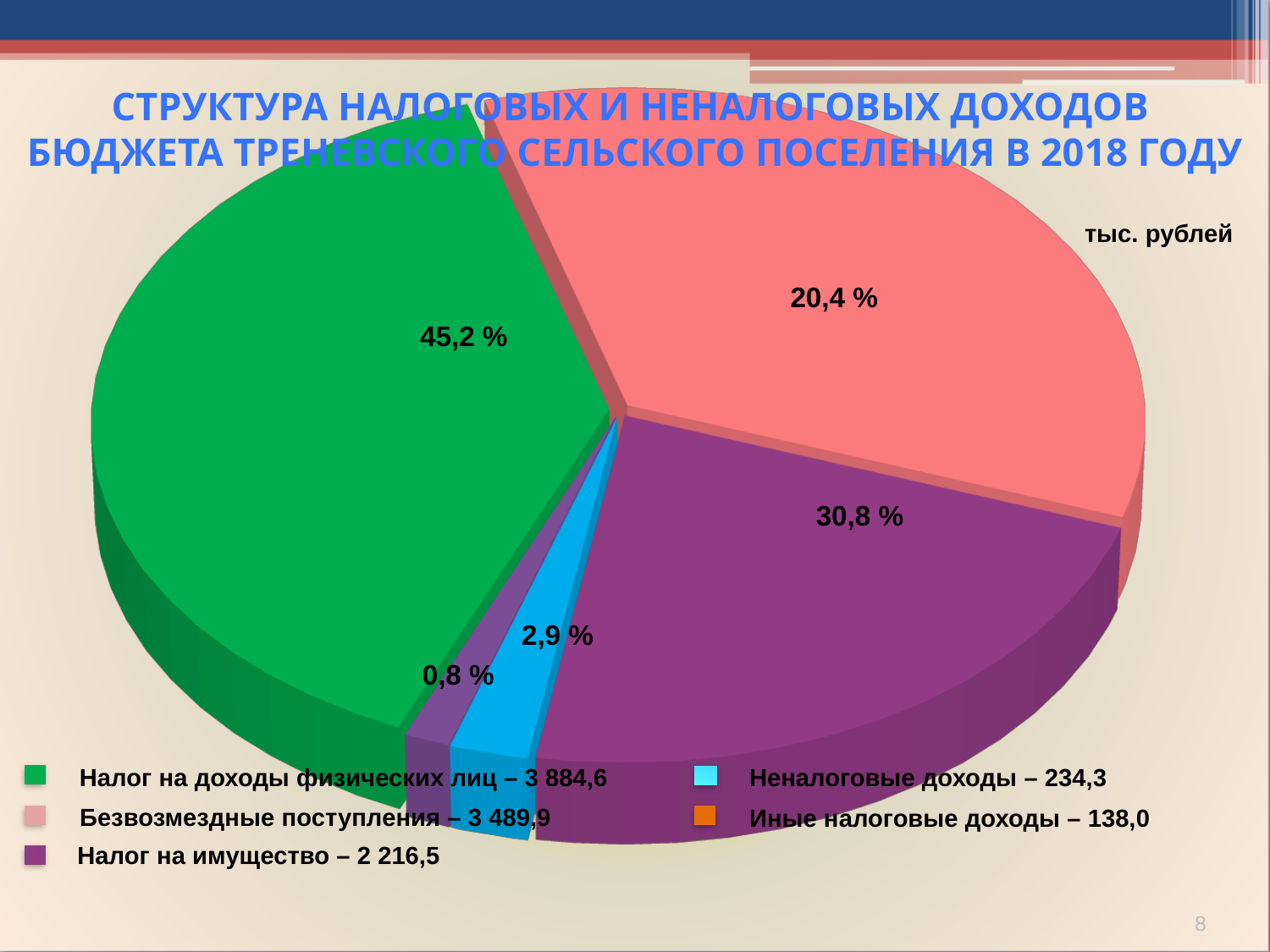
Which category has the smallest value in the pie chart? Иные налоговые доходы What percentage is printed on the green slice of the pie chart? 45,2 % In what units are the values on the slide given? тыс. рублей What share of the pie does «Неналоговые доходы» (the light blue slice) have? 2,9 % What type of chart is shown on the slide? pie chart How many categories does the legend of the pie chart list? 5 What is the difference between the legend values for «Налог на доходы физических лиц» and «Безвозмездные поступления»? 394,7 What value does the legend give for «Иные налоговые доходы»? 138,0 What value does the legend give for «Налог на доходы физических лиц»? 3 884,6 Which category has the largest value in the pie chart? Налог на доходы физических лиц What value does the legend give for «Неналоговые доходы»? 234,3 Which is larger, «Налог на имущество» or «Неналоговые доходы»? Налог на имущество